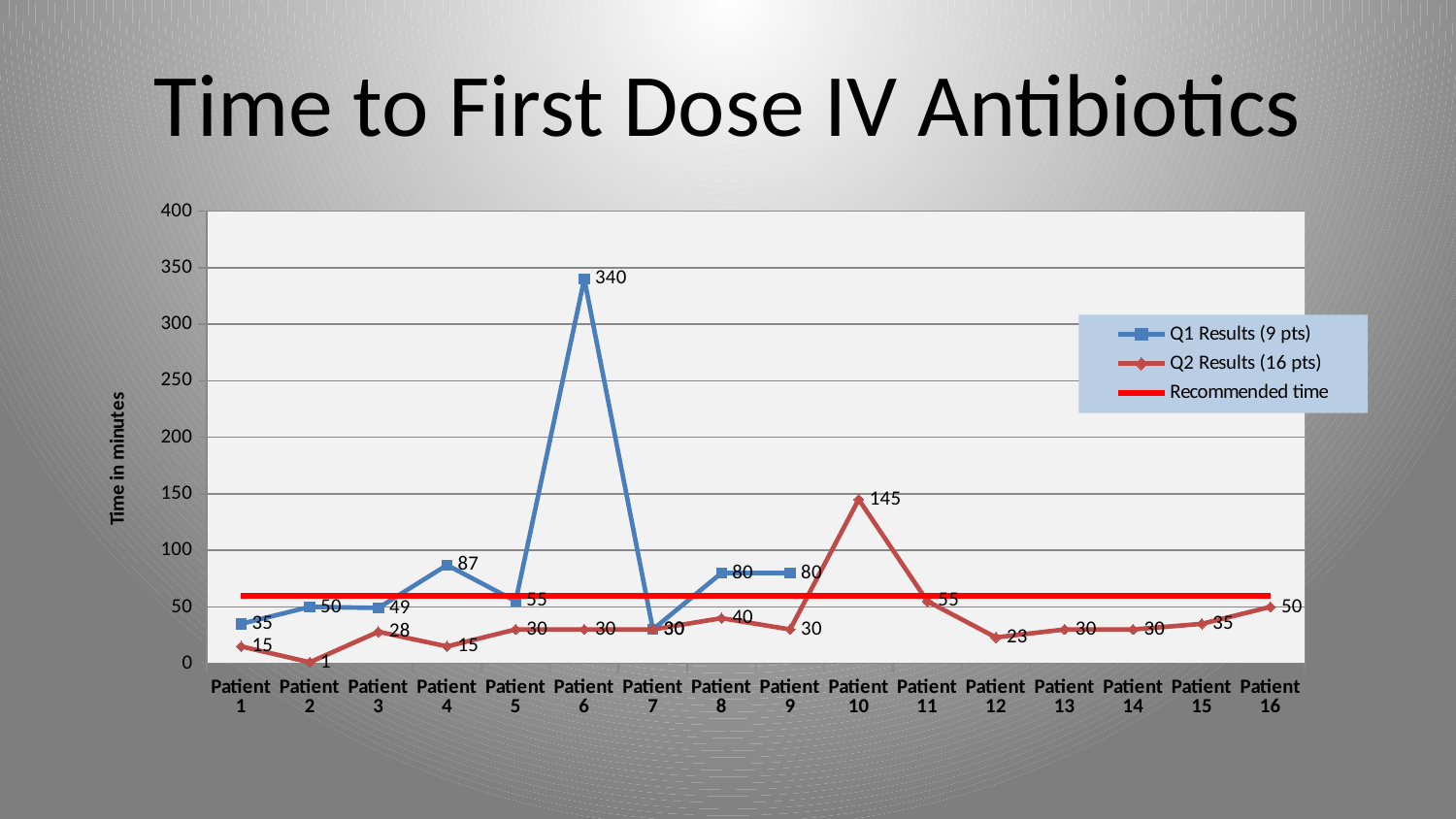
What is the Q1 Results value for Patient 6? 340 What kind of chart is shown on the slide? line chart What is the Q1 Results value for Patient 9? 80 Which patient has the highest Q1 Results value? Patient 6 What is the Q2 Results value for Patient 10? 145 How many series does the legend list? 3 For Patient 4, which series has the larger value, Q1 Results or Q2 Results? Q1 Results How many patients are shown on the x axis? 16 Which patient has the highest Q2 Results value? Patient 10 Is the Recommended time line greater or less than 100 minutes? less What is the difference between the Q1 Results and Q2 Results values for Patient 6? 310 Which patient has the lowest Q2 Results value? Patient 2